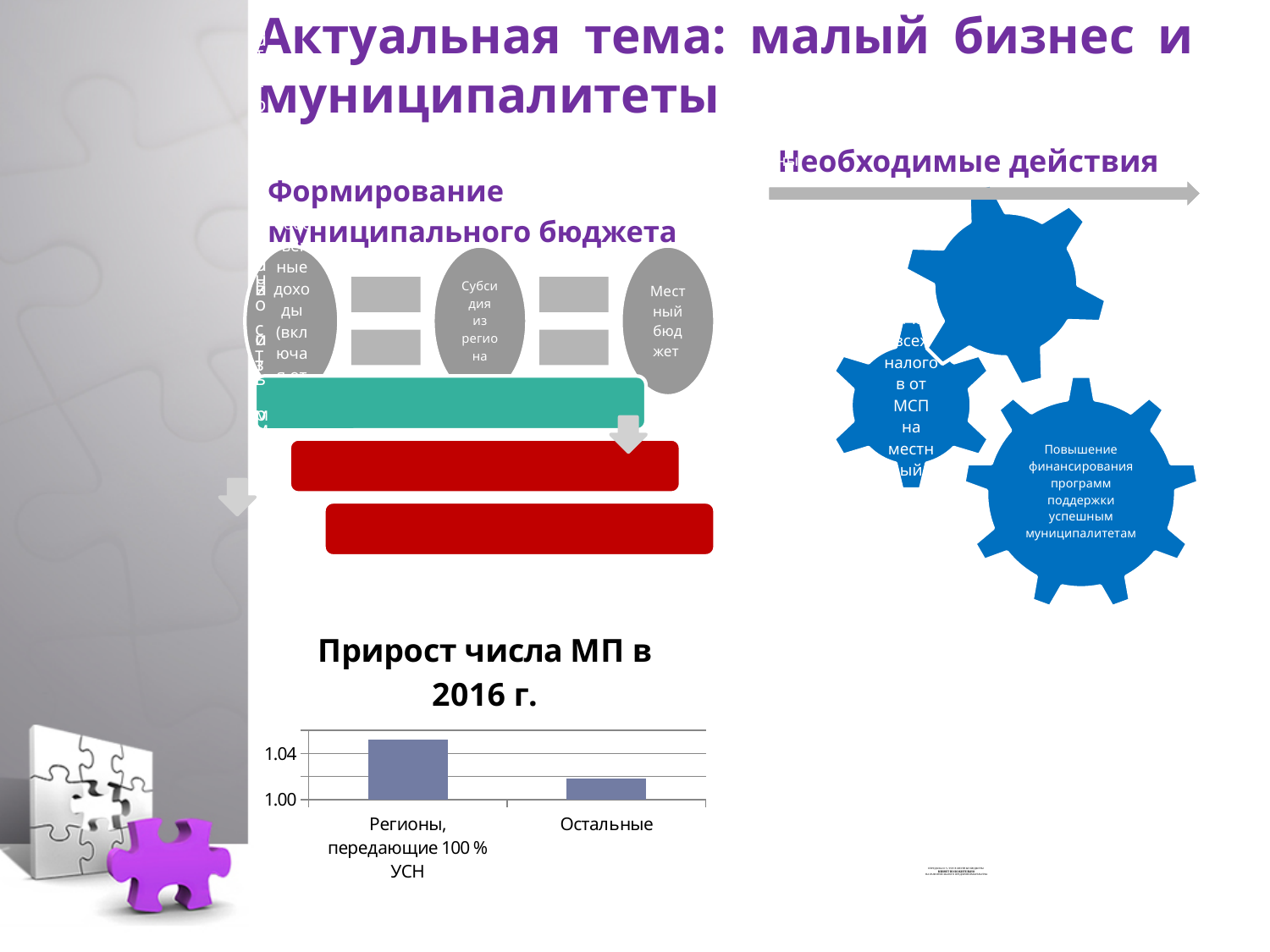
Which category has the highest value in the "Прирост числа МП в 2016 г." chart? Регионы, передающие 100 % УСН What is the title of the bar chart at the bottom of the slide? Прирост числа МП в 2016 г. In the "Прирост числа МП в 2016 г." chart, which is larger: the value for "Регионы, передающие 100 % УСН" or the value for "Остальные"? Регионы, передающие 100 % УСН Which category has the lowest value in the "Прирост числа МП в 2016 г." chart? Остальные How many categories are plotted in the "Прирост числа МП в 2016 г." chart? 2 Do the bar values rise or fall from left to right in the "Прирост числа МП в 2016 г." chart? fall What is the lowest tick value shown on the y axis of the "Прирост числа МП в 2016 г." chart? 1.00 What kind of chart is shown under the title "Прирост числа МП в 2016 г."? bar chart In the "Прирост числа МП в 2016 г." chart, is the value for "Регионы, передающие 100 % УСН" greater or less than 1.04? greater In the "Прирост числа МП в 2016 г." chart, is the value for "Остальные" greater or less than 1.00? greater In the "Прирост числа МП в 2016 г." chart, is the value for "Остальные" greater or less than 1.04? less